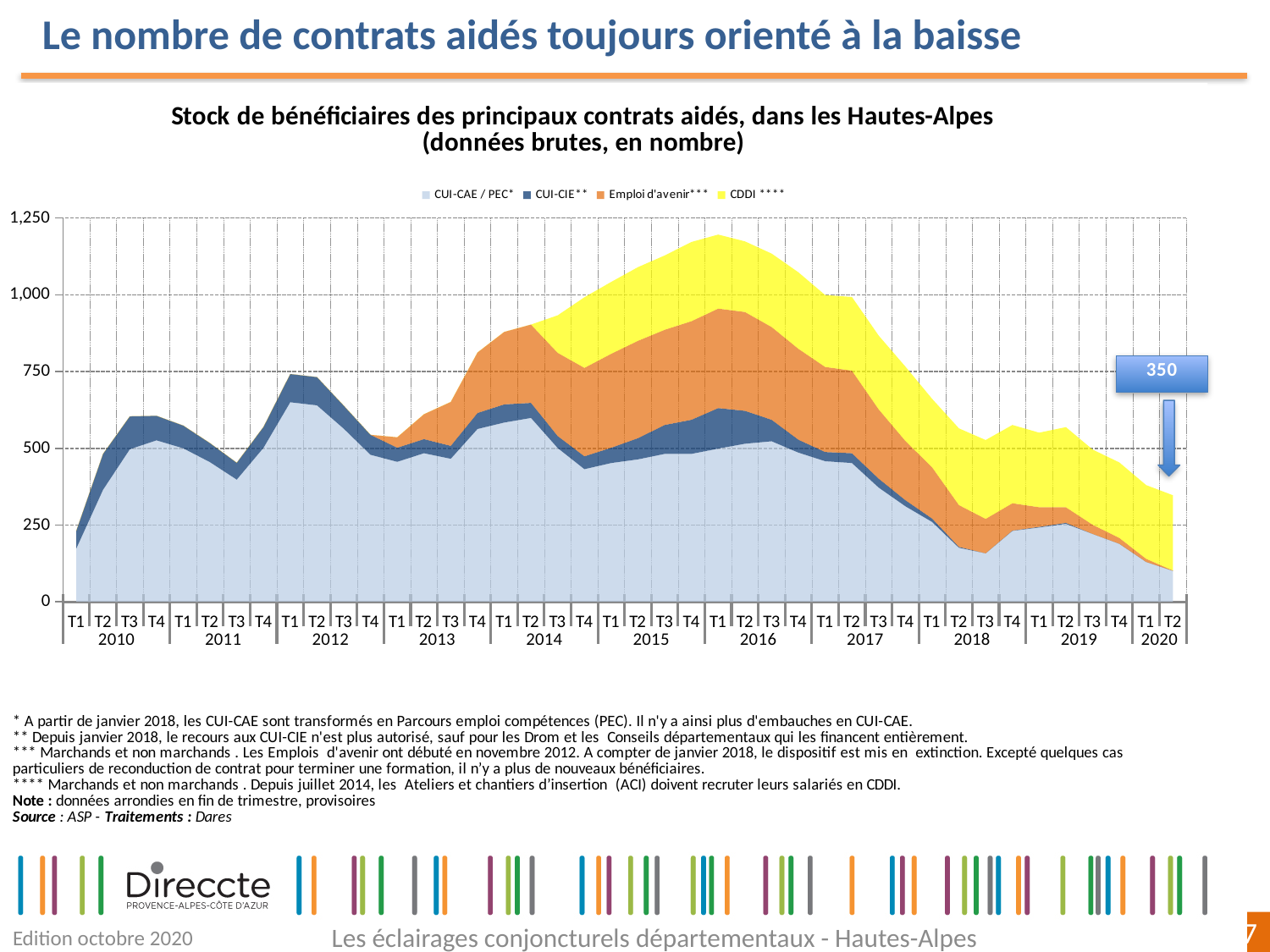
Is the stacked total at T1 2018 greater or less than 750? less Is the stacked total at T1 2010 greater or less than 500? less Is the stacked total at T1 2012 greater or less than 500? greater Which series is shown in yellow in the legend? CDDI **** How many series does the chart legend list? 4 What total value is labelled by the callout at the end of the chart (T2 2020)? 350 How many years are labelled along the x axis? 11 What kind of chart is shown on the slide? stacked area chart What is the title of the chart? Stock de bénéficiaires des principaux contrats aidés, dans les Hautes-Alpes (données brutes, en nombre) Does the stacked total rise or fall between 2016 and 2020? fall